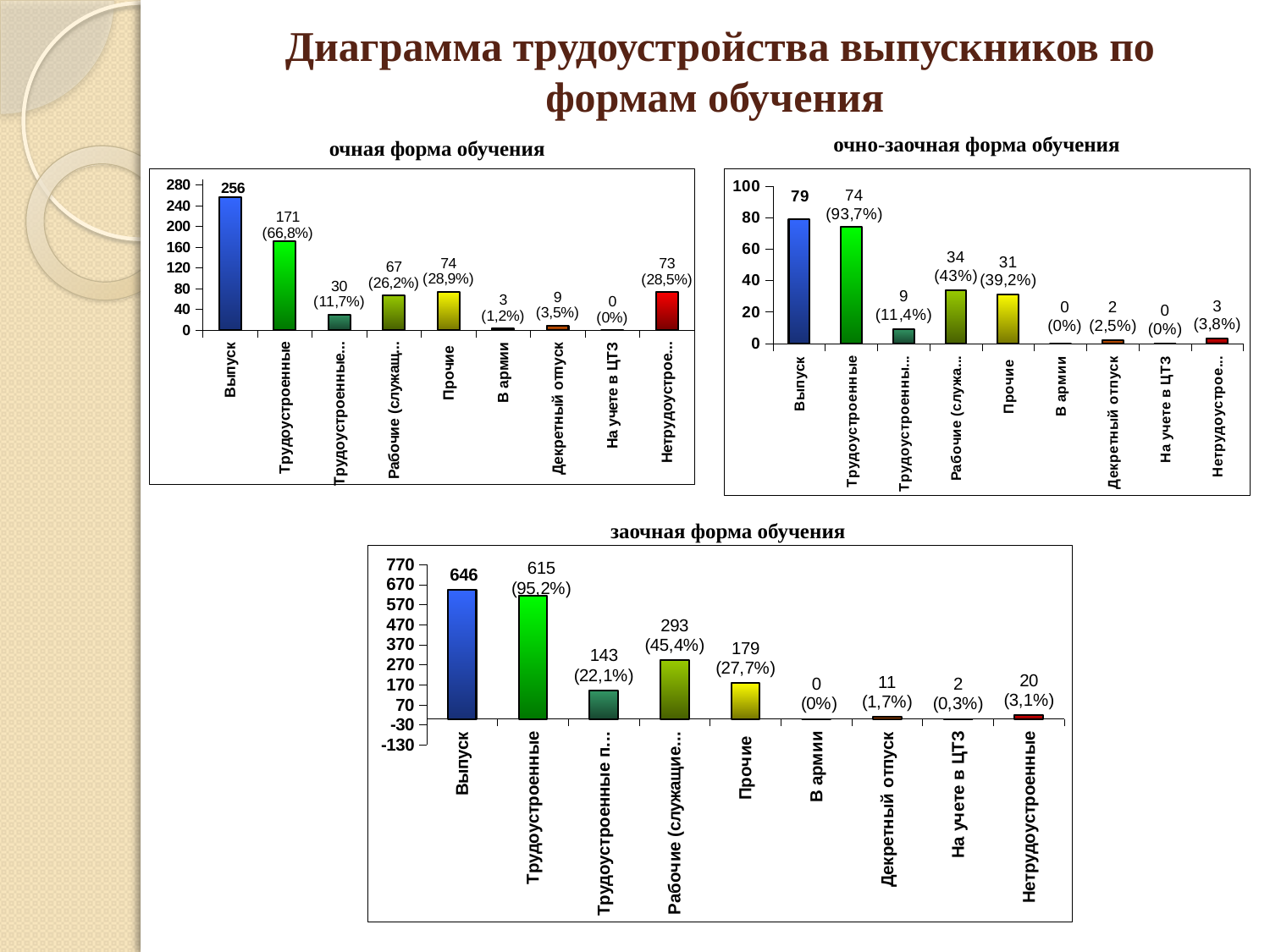
In the chart titled "заочная форма обучения", which is larger, the value for Прочие or the value for Нетрудоустроенные? Прочие In the chart titled "заочная форма обучения", what is the value for Декретный отпуск? 11 In the chart titled "очная форма обучения", what is the value for Выпуск? 256 In the chart titled "очно-заочная форма обучения", what percentage is shown for Прочие? 39,2% In the chart titled "очная форма обучения", what percentage is shown for Трудоустроенные? 66,8% In the chart titled "очная форма обучения", what is the value for Прочие? 74 What type of chart is the chart titled "очная форма обучения"? Bar chart In the chart titled "очно-заочная форма обучения", which category has the highest value? Выпуск In the chart titled "очная форма обучения", what is the difference between the values for Выпуск and Трудоустроенные? 85 In the chart titled "заочная форма обучения", which category has the lowest value? В армии and На учете в ЦТЗ (both 0) In the chart titled "очно-заочная форма обучения", what is the value for Трудоустроенные? 74 How many categories are shown in the chart titled "заочная форма обучения"? 9